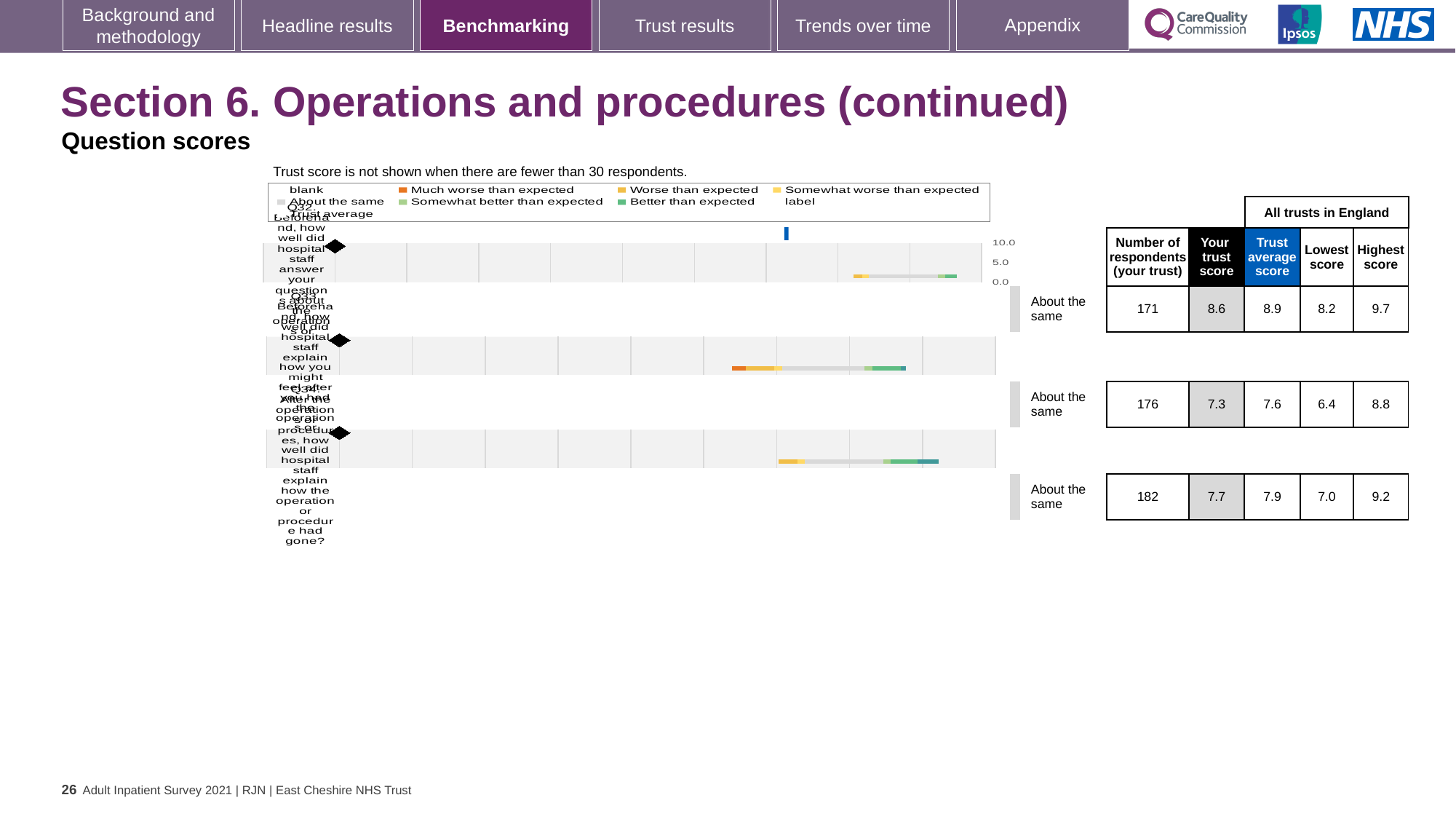
Which question row has the lowest 'Lowest score' across all trusts in England? the second (middle) row What is the trust score for the second (middle) question row? 7.3 What is the number of respondents for the first (top) question row? 171 What is the highest value shown on the chart's score axis? 10.0 What benchmark category is shown next to each of the three bars in the chart? About the same What kind of chart is used to show the benchmarking results on this slide? bar chart How many question rows (bars) are shown in the benchmarking chart? 3 What is the difference between the highest score and the lowest score for the first (top) question row? 1.5 What is the trust average score for the third (bottom) question row? 7.9 Which row has more respondents, the second (middle) row or the third (bottom) row? the third (bottom) row Which question row has the highest 'Your trust score'? the first (top) row Is the trust score for the second (middle) row larger or smaller than the trust average score for that row? smaller